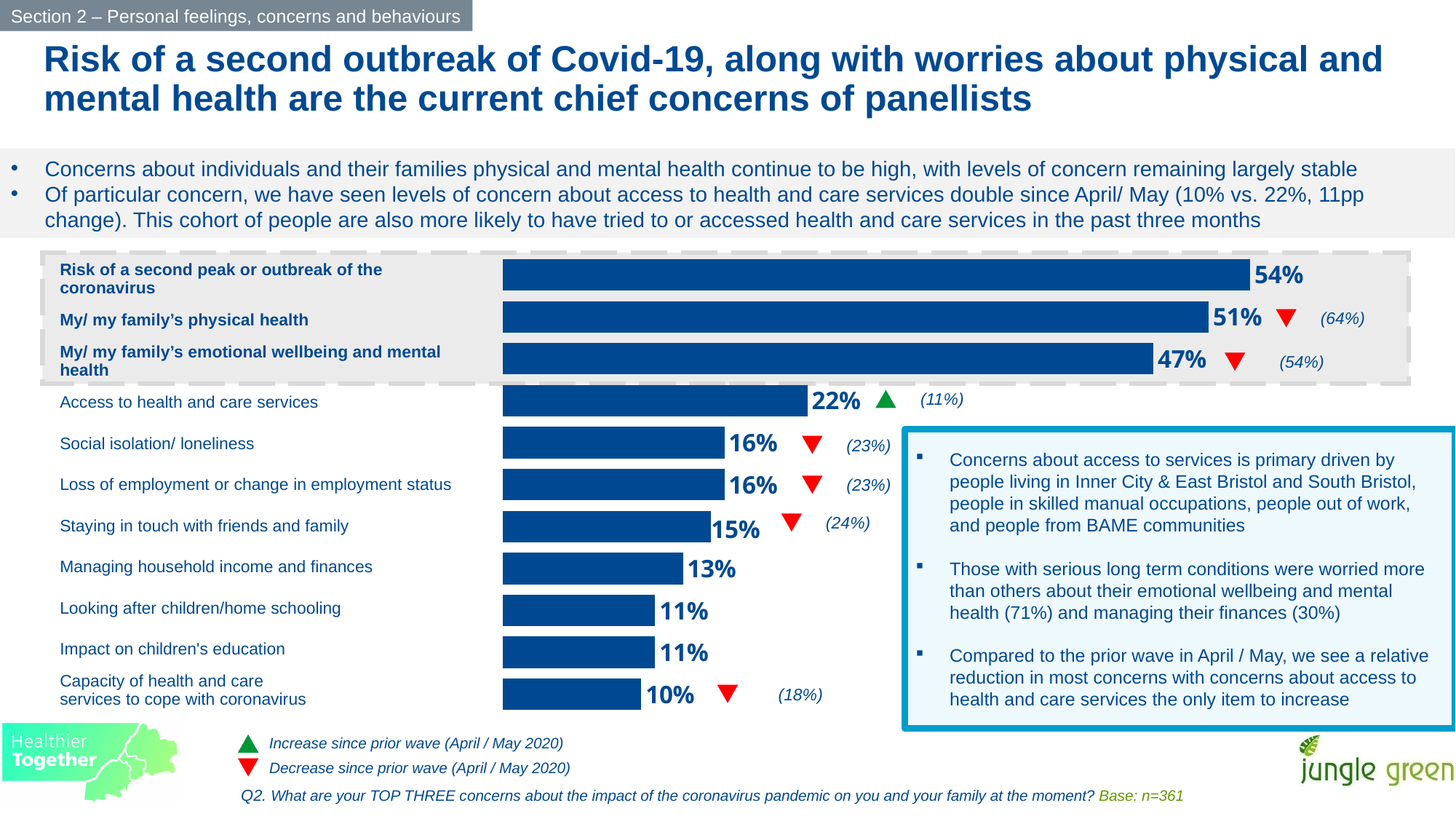
Which concern has the highest percentage in the chart? Risk of a second peak or outbreak of the coronavirus What percentage of panellists cited 'Risk of a second peak or outbreak of the coronavirus' as a concern? 54% Which concern has the lowest percentage in the chart? Capacity of health and care services to cope with coronavirus Which concern is marked with a green upward triangle indicating an increase since the prior wave? Access to health and care services What is the value shown for 'Managing household income and finances'? 13% What was the prior wave (April / May 2020) value shown in brackets for 'My/ my family's physical health'? 64% What type of chart is used to show the concerns? Bar chart What does the red downward triangle in the chart legend indicate? Decrease since prior wave (April / May 2020) What is the difference in percentage points between 'My/ my family's physical health' and 'My/ my family's emotional wellbeing and mental health'? 4 percentage points How many concern categories are plotted in the bar chart? 11 What is the value shown for 'Access to health and care services'? 22% Which is larger: the value for 'Social isolation/ loneliness' or the value for 'Staying in touch with friends and family'? Social isolation/ loneliness